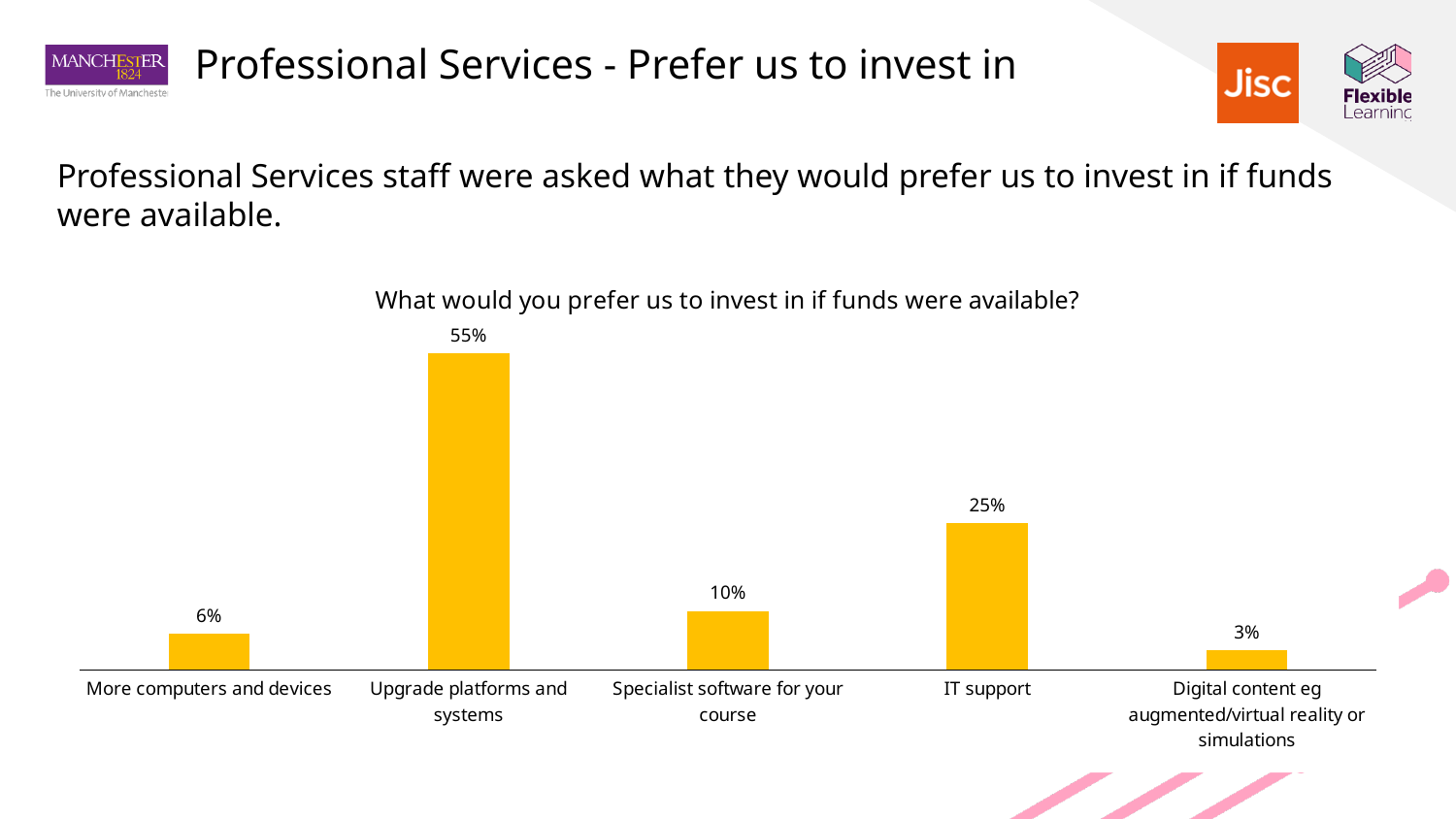
What percentage of Professional Services staff chose 'Upgrade platforms and systems'? 55% What is the value for 'More computers and devices'? 6% Which is larger, 'IT support' or 'Specialist software for your course'? IT support How many categories are shown in the chart? 5 What is the value for 'Digital content eg augmented/virtual reality or simulations'? 3% What is the title of the chart? What would you prefer us to invest in if funds were available? What is the difference between 'Upgrade platforms and systems' and 'IT support'? 30% What is the difference between 'Specialist software for your course' and 'More computers and devices'? 4% What is the value for 'IT support'? 25% Which category has the lowest value? Digital content eg augmented/virtual reality or simulations Which category has the highest value? Upgrade platforms and systems What kind of chart is shown on the slide? Bar chart